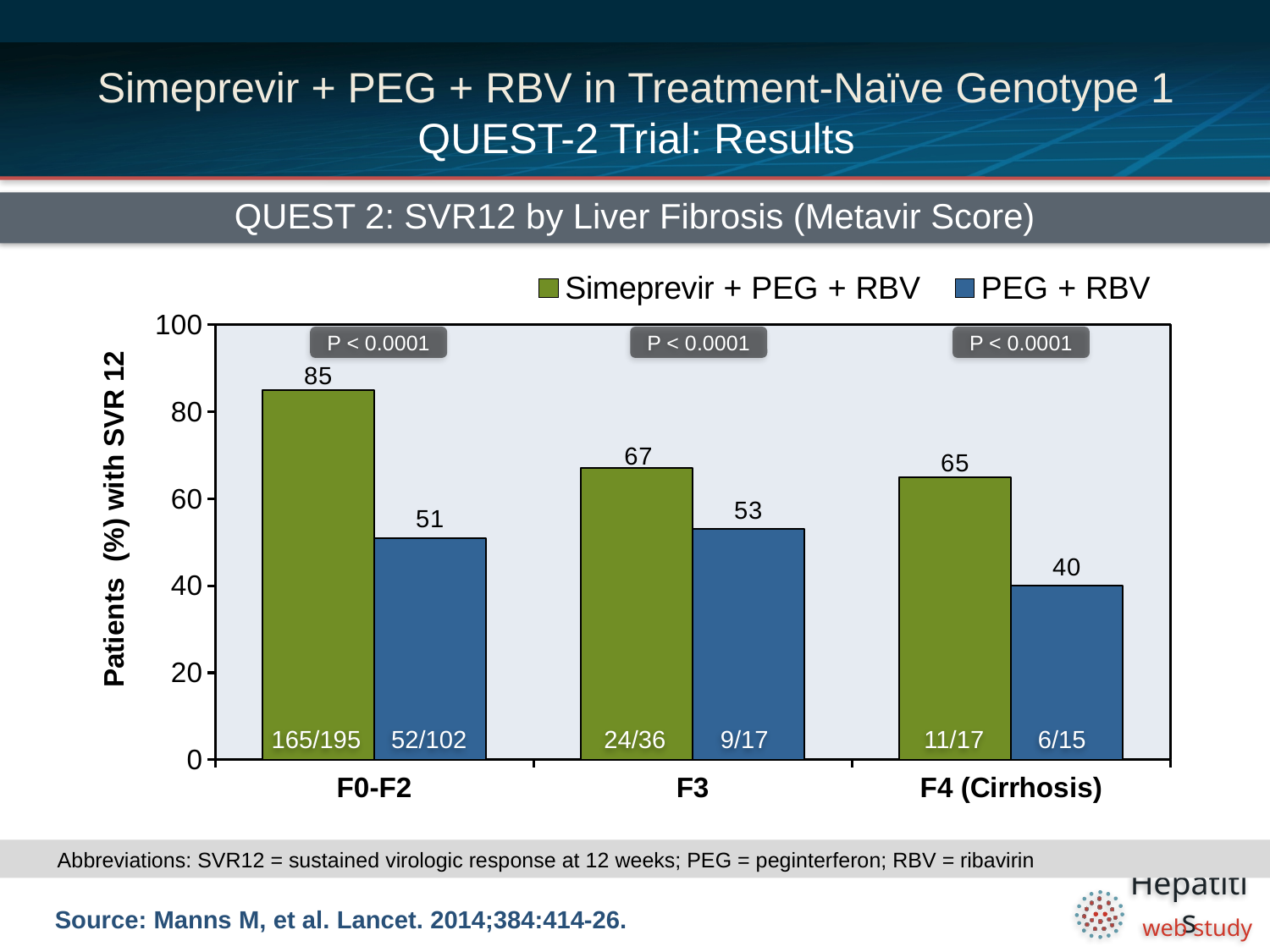
In the F4 (Cirrhosis) group, which treatment has the higher SVR12 rate? Simeprevir + PEG + RBV Do the Simeprevir + PEG + RBV SVR12 rates rise or fall from F0-F2 to F4 (Cirrhosis)? Fall What kind of chart is shown on the slide? Bar chart What is the SVR12 rate for Simeprevir + PEG + RBV in the F0-F2 group? 85 What is the SVR12 rate for PEG + RBV in the F4 (Cirrhosis) group? 40 How many fibrosis categories are shown on the x axis? 3 What is the SVR12 rate for PEG + RBV in the F3 group? 53 What is the difference between the Simeprevir + PEG + RBV and PEG + RBV SVR12 rates in the F0-F2 group? 34 How many series does the legend list? 2 Which fibrosis group has the lowest SVR12 rate for PEG + RBV? F4 (Cirrhosis) Which fibrosis group has the highest SVR12 rate for Simeprevir + PEG + RBV? F0-F2 What fraction of patients is printed on the PEG + RBV bar for the F3 group? 9/17